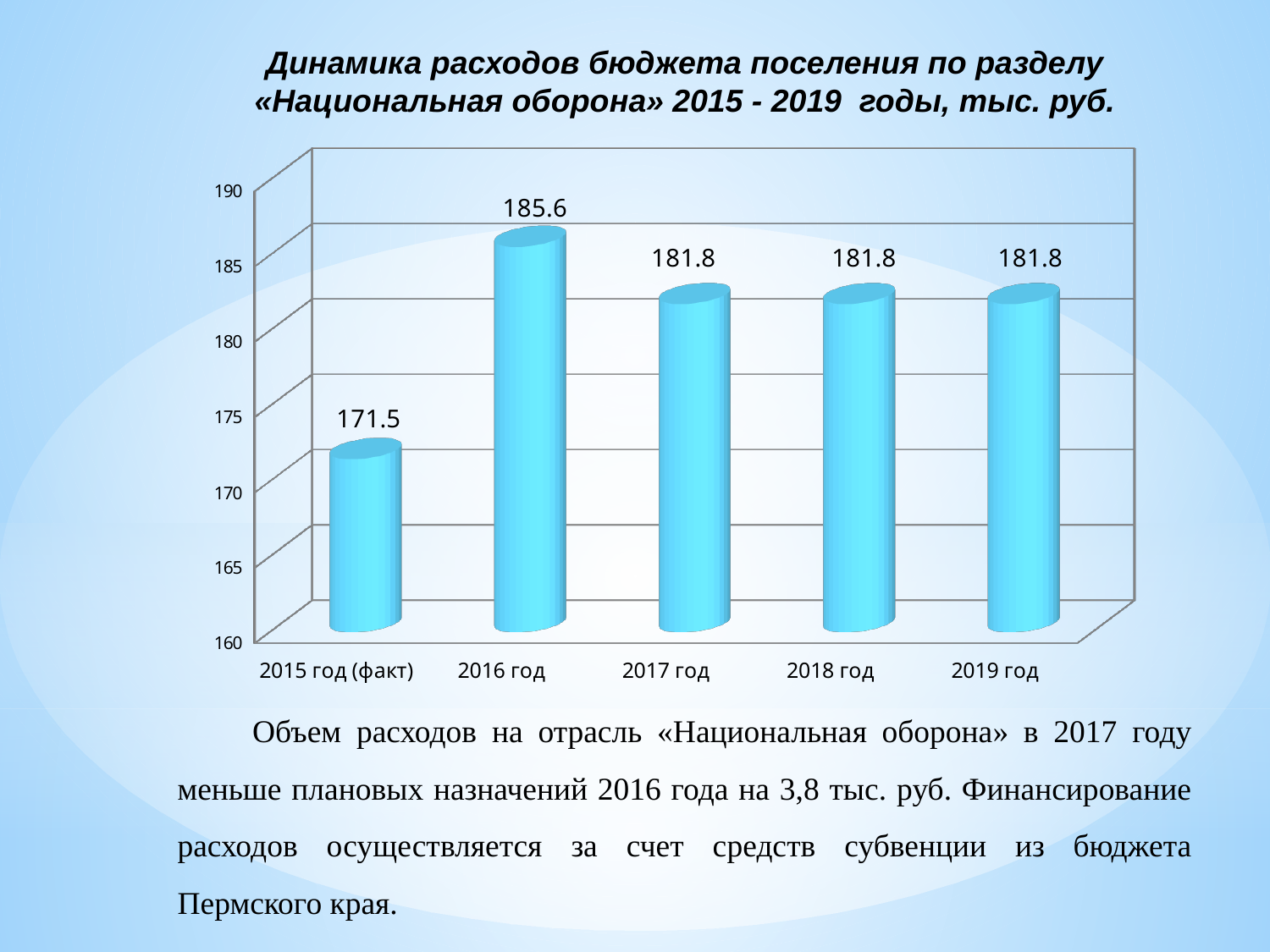
Which year has the lowest value? 2015 год (факт) Do the values change between 2017 год and 2019 год? No, they stay at 181.8 How many years are shown on the chart? 5 What is the value for 2015 год (факт)? 171.5 What is the difference between the values for 2016 год and 2015 год (факт)? 14.1 What is the difference between the values for 2016 год and 2017 год? 3.8 Which year has the highest value? 2016 год What kind of chart is shown on the slide? bar chart Is the value for 2015 год (факт) greater or less than 175? less Which is larger, the value for 2015 год (факт) or the value for 2019 год? 2019 год What is the value for 2016 год? 185.6 What is the value for 2018 год? 181.8